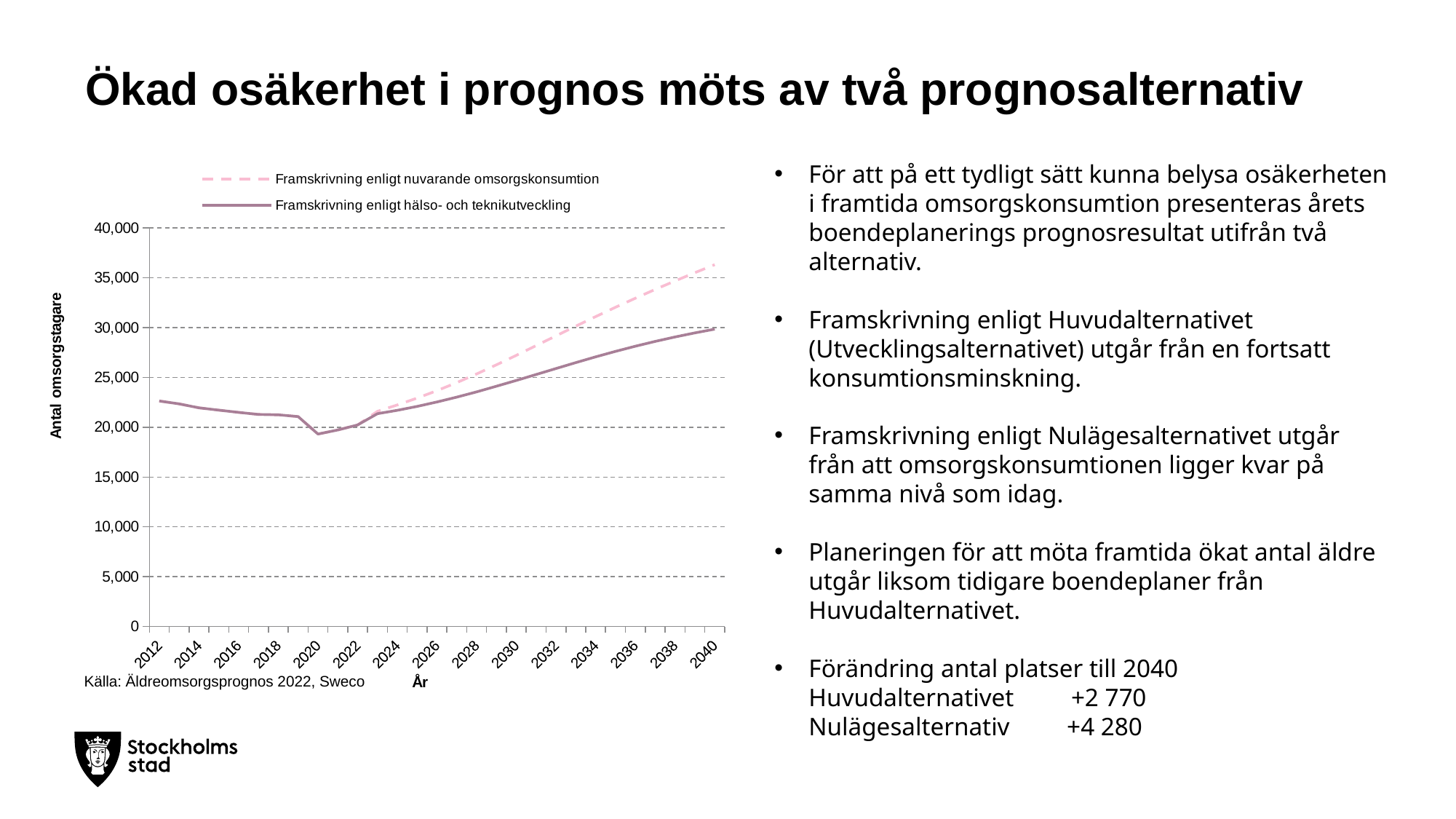
How many series does the chart legend list? 2 Is the value for 'Framskrivning enligt hälso- och teknikutveckling' in 2036 greater or less than 30,000? less Is the value for 'Framskrivning enligt nuvarande omsorgskonsumtion' in 2034 greater or less than 30,000? greater What kind of chart is shown on the slide? line chart Is the value for 'Framskrivning enligt hälso- och teknikutveckling' in 2012 greater or less than 20,000? greater Which series has the higher value in 2040? Framskrivning enligt nuvarande omsorgskonsumtion What is the title of the vertical axis? Antal omsorgstagare Do the values of 'Framskrivning enligt nuvarande omsorgskonsumtion' rise or fall from 2024 to 2040? rise In which year does the 'Framskrivning enligt hälso- och teknikutveckling' series reach its lowest value? 2020 What is the label of the dashed series in the legend? Framskrivning enligt nuvarande omsorgskonsumtion